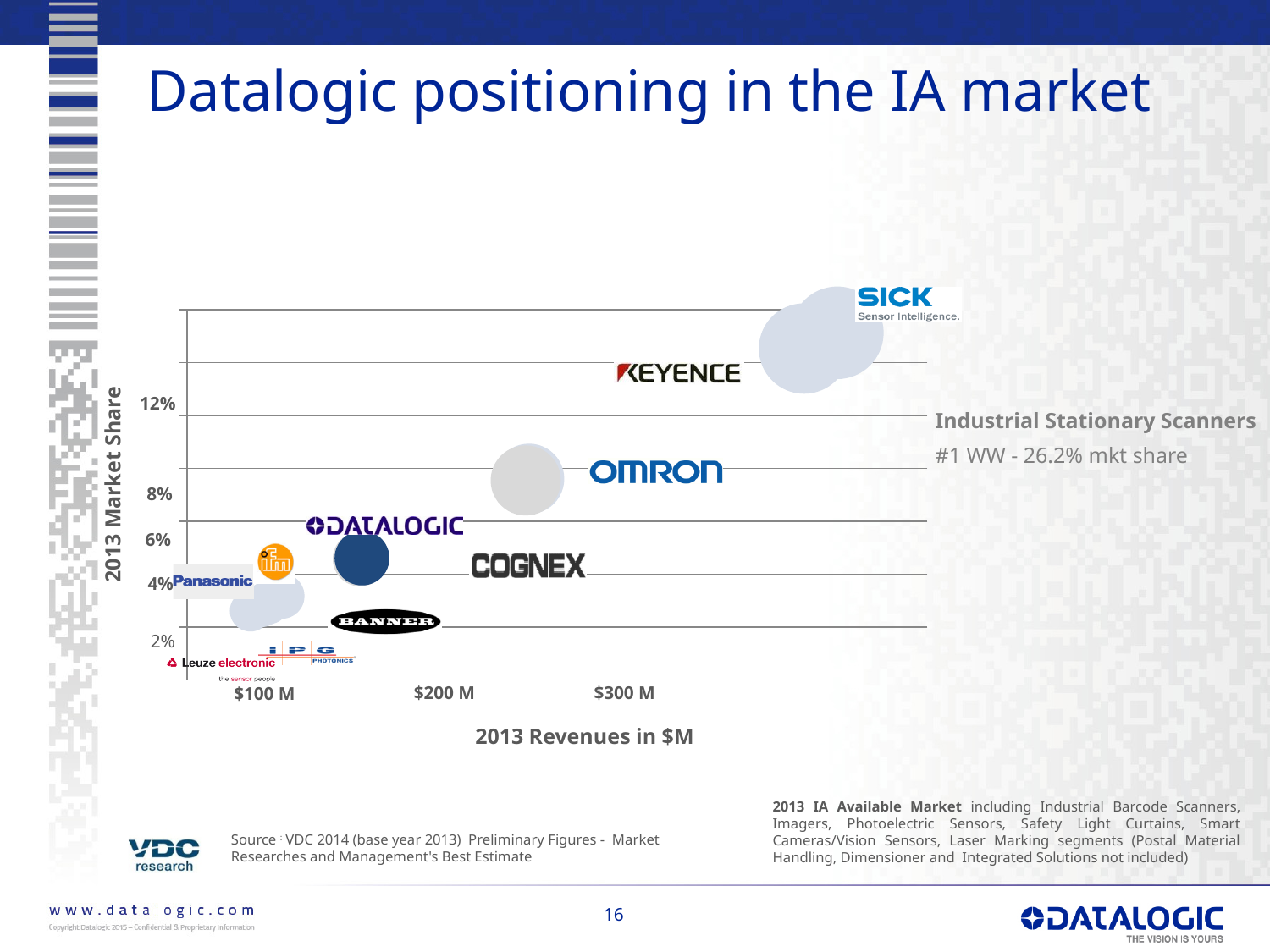
What is the label of the vertical axis of the chart? 2013 Market Share Which has the larger 2013 revenues, Keyence or Cognex? Keyence Are the 2013 revenues for SICK greater or less than $300 M? greater Is the 2013 market share for Panasonic greater or less than 4%? less What is the label of the horizontal axis of the chart? 2013 Revenues in $M Which company has the highest 2013 market share in the chart? SICK What kind of chart is shown on the slide? Bubble chart What market share does the slide state Datalogic holds in Industrial Stationary Scanners? 26.2% Is the 2013 market share for SICK greater or less than 12%? greater Which has the larger 2013 market share, Omron or Datalogic? Omron How many companies are positioned in the chart? 10